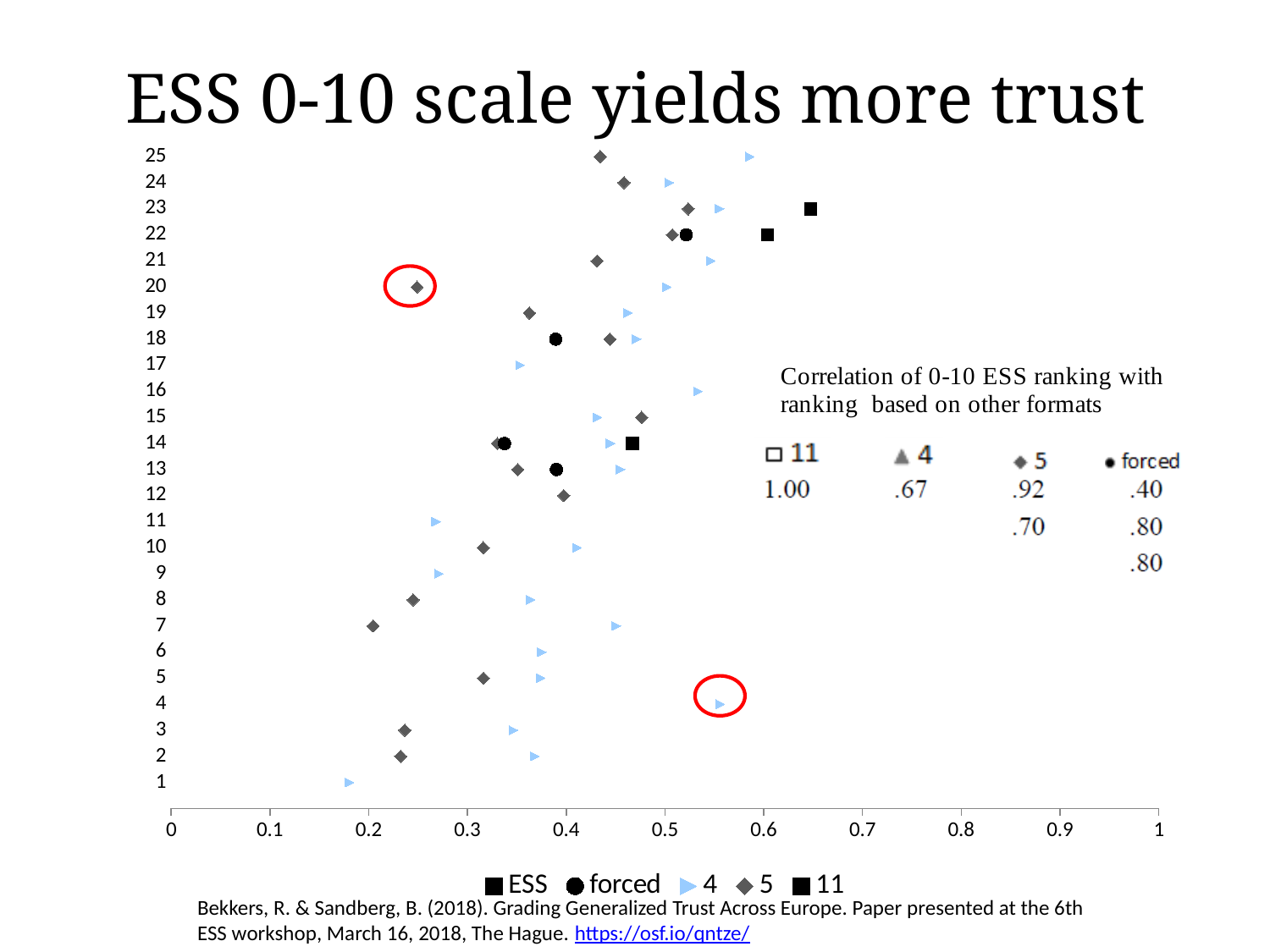
Do the values for series 5 generally increase or decrease as the rank goes from 1 up to 25? increase Is the value for series 5 at rank 20 (the circled diamond) greater or less than 0.3? less Is the value for the forced series at rank 22 greater or less than 0.6? less Is the value for series 11 at rank 23 greater or less than 0.6? greater At rank 23, which series has the larger value, 11 or 5? 11 How many series does the chart legend list? 5 At rank 20, which series has the larger value, 4 or 5? 4 What kind of chart is shown on the slide? scatter chart How many rank positions are shown on the vertical axis of the chart? 25 What is the title of the slide containing the chart? ESS 0-10 scale yields more trust